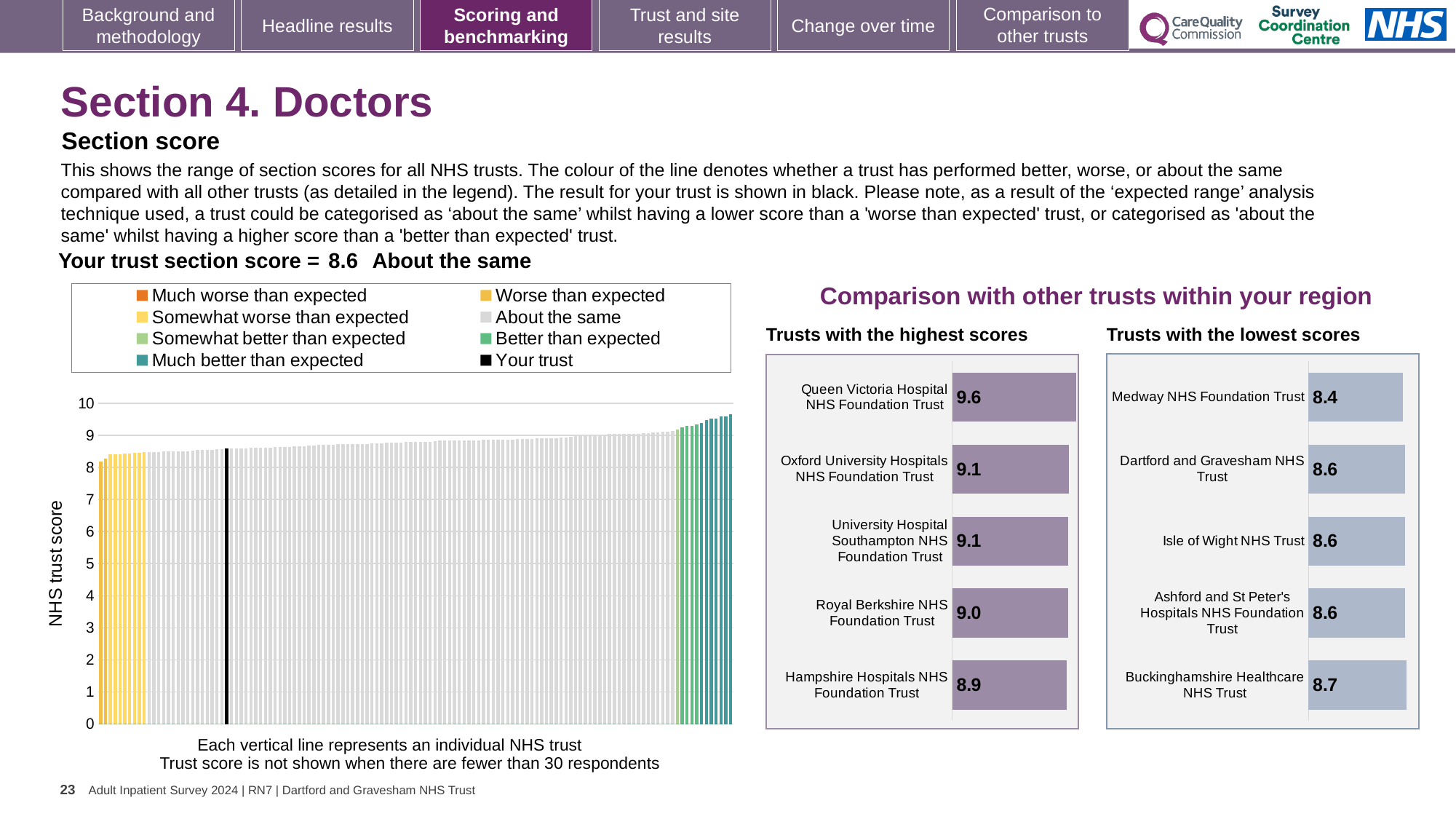
In the 'Trusts with the lowest scores' chart, what is the score for Buckinghamshire Healthcare NHS Trust? 8.7 In the 'Trusts with the highest scores' chart, which trust has the highest score? Queen Victoria Hospital NHS Foundation Trust In the 'Trusts with the highest scores' chart, what is the score for Hampshire Hospitals NHS Foundation Trust? 8.9 In the 'Trusts with the highest scores' chart, what is the difference between the scores of Queen Victoria Hospital NHS Foundation Trust and Royal Berkshire NHS Foundation Trust? 0.6 In the 'Trusts with the lowest scores' chart, which has the larger score: Medway NHS Foundation Trust or Buckinghamshire Healthcare NHS Trust? Buckinghamshire Healthcare NHS Trust How many trusts are shown in the 'Trusts with the highest scores' chart? 5 In the 'Trusts with the highest scores' chart, what is the score for Queen Victoria Hospital NHS Foundation Trust? 9.6 What kind of chart is the NHS trust score chart on the left of the slide? Bar chart In the 'Trusts with the lowest scores' chart, which trust has the lowest score? Medway NHS Foundation Trust How many entries does the legend of the NHS trust score chart on the left list? 8 In the 'Trusts with the lowest scores' chart, what is the score for Medway NHS Foundation Trust? 8.4 In the NHS trust score chart on the left, do the trust scores rise or fall from left to right along the x axis? Rise